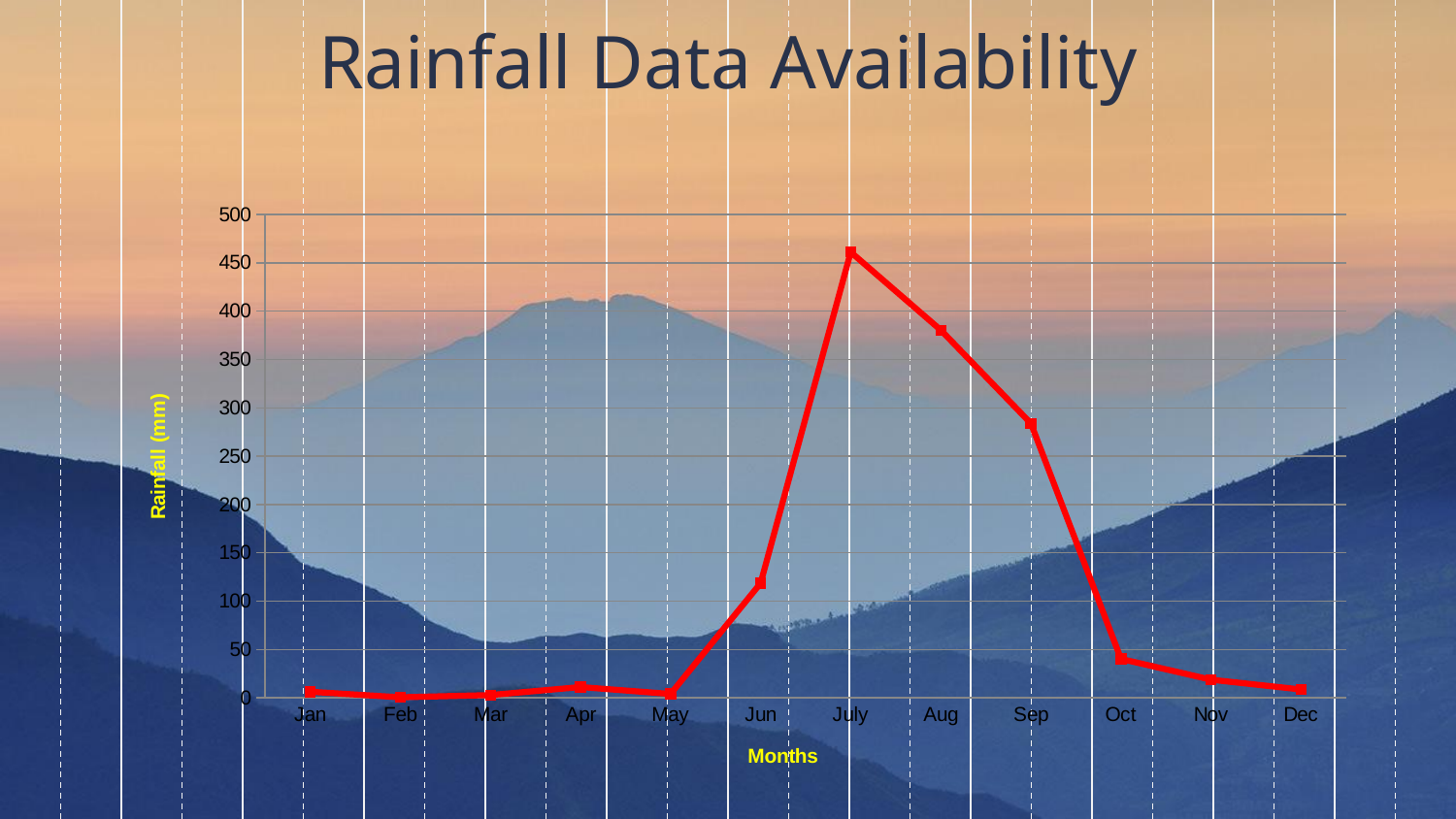
Is the rainfall value for Sep greater or less than 250? greater Do the rainfall values rise or fall from July to Dec? fall Is the rainfall value for July greater or less than 400? greater Is the rainfall value for Aug greater or less than 350? greater Which month has the highest rainfall? July What is the label on the x axis? Months What kind of chart is shown on the slide? line chart Which month has higher rainfall, Aug or Sep? Aug How many months are plotted along the x axis? 12 What is the label on the y axis? Rainfall (mm)